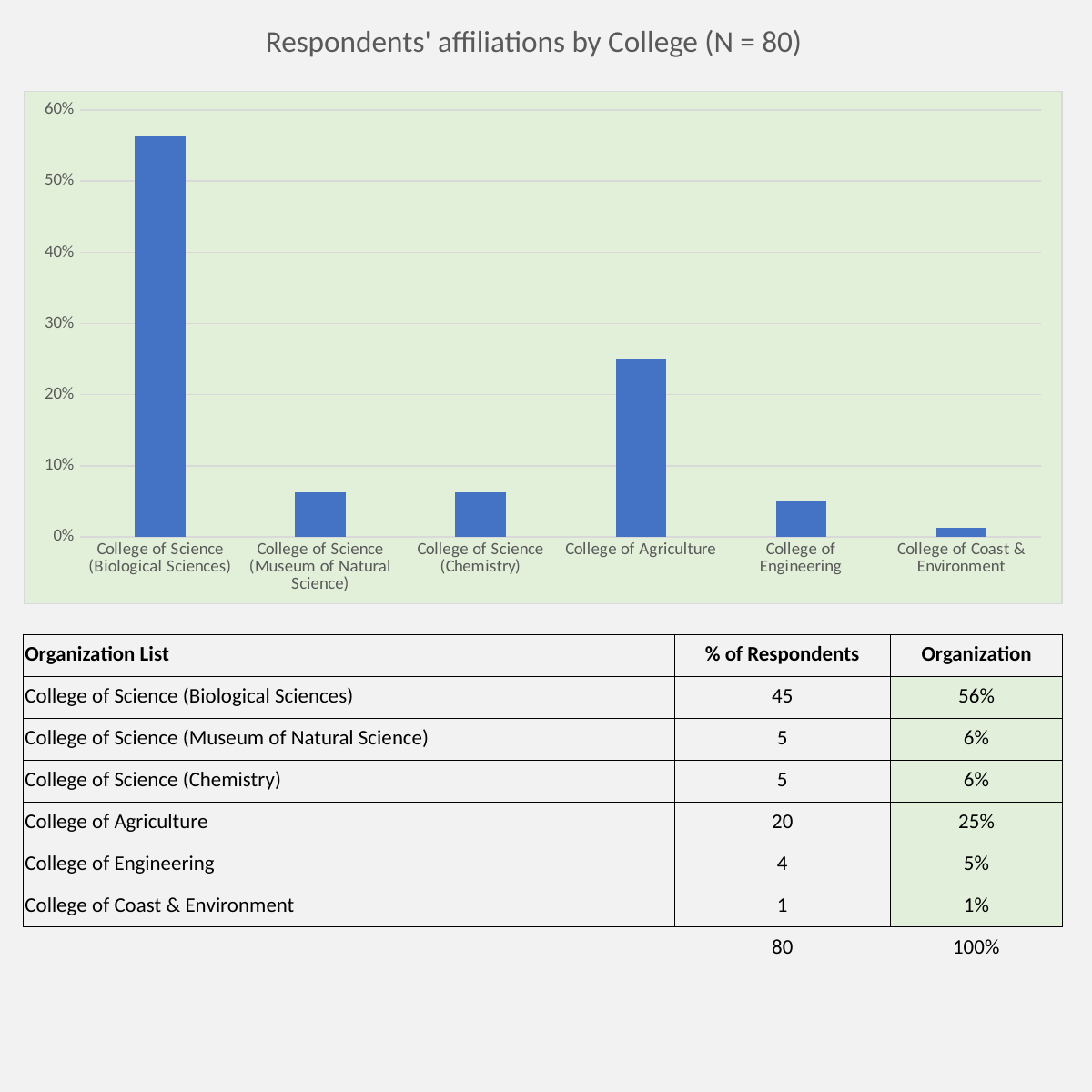
Is the value for College of Science (Biological Sciences) greater or less than 50%? greater Which college has the highest bar in the chart? College of Science (Biological Sciences) Is the value for College of Agriculture greater or less than 30%? less What kind of chart is shown on the slide? bar chart According to the slide, what percentage of respondents are from the College of Agriculture? 25% According to the slide, what percentage of respondents are from the College of Science (Biological Sciences)? 56% How many colleges are shown on the x axis of the chart? 6 What is the title of the chart? Respondents' affiliations by College (N = 80) Which college has the lowest bar in the chart? College of Coast & Environment Is the value for College of Engineering greater or less than 10%? less Which is larger, the value for College of Agriculture or the value for College of Engineering? College of Agriculture What is the difference in percentage points between College of Science (Biological Sciences) and College of Agriculture, using the values printed on the slide? 31%